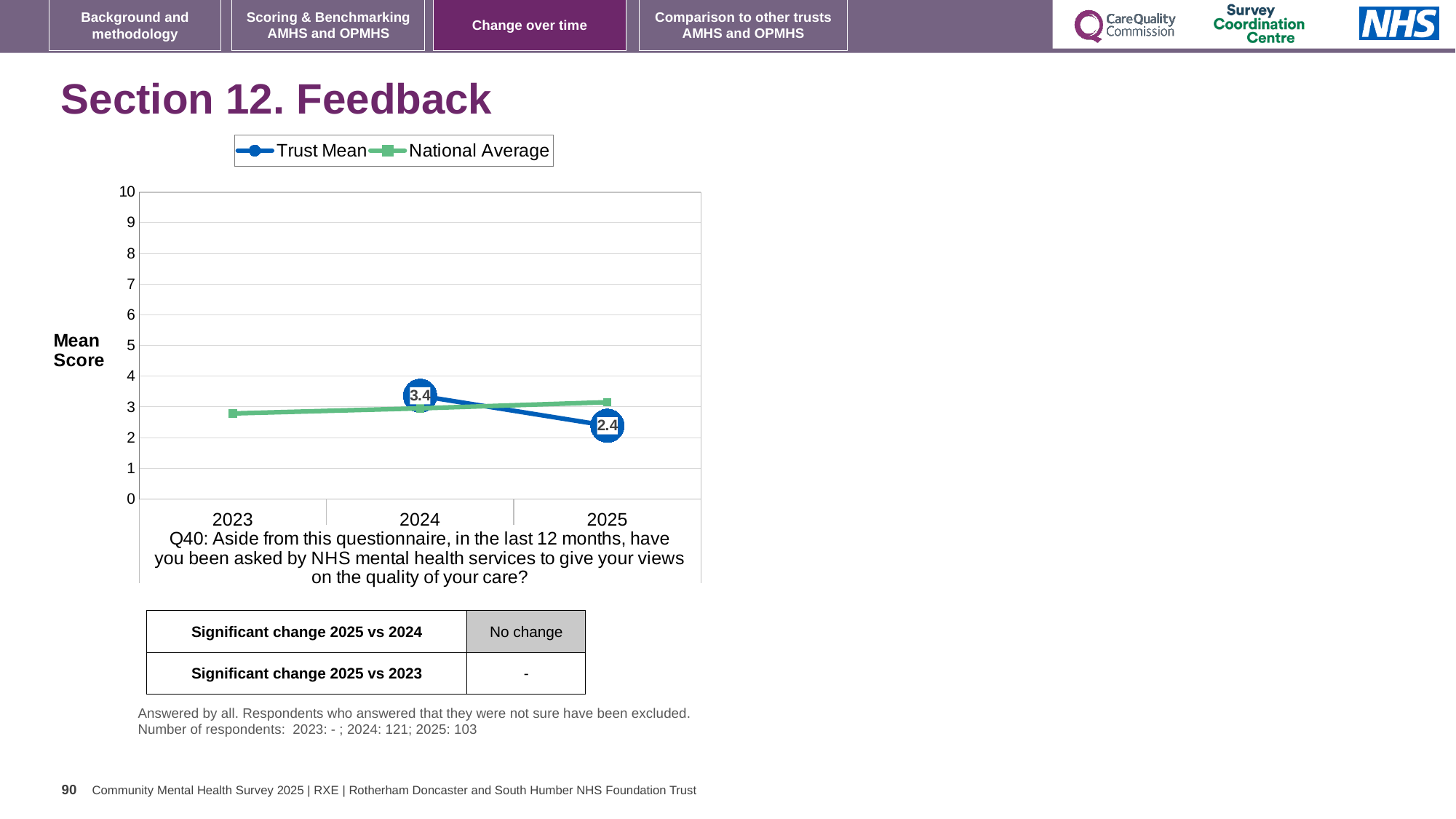
Does the Trust Mean rise or fall from 2024 to 2025? fall Is the National Average for 2023 greater or less than 4? less What is the label on the vertical axis of the chart? Mean Score Which year has the higher Trust Mean, 2024 or 2025? 2024 How many series does the legend list? 2 What is the difference between the Trust Mean in 2024 and in 2025? 1.0 What is the Trust Mean value for 2024? 3.4 What kind of chart is shown on the slide? line chart Does the National Average rise or fall from 2023 to 2025? rise Is the National Average for 2025 greater or less than 5? less What is the Trust Mean value for 2025? 2.4 In 2025, which is higher: the Trust Mean or the National Average? National Average